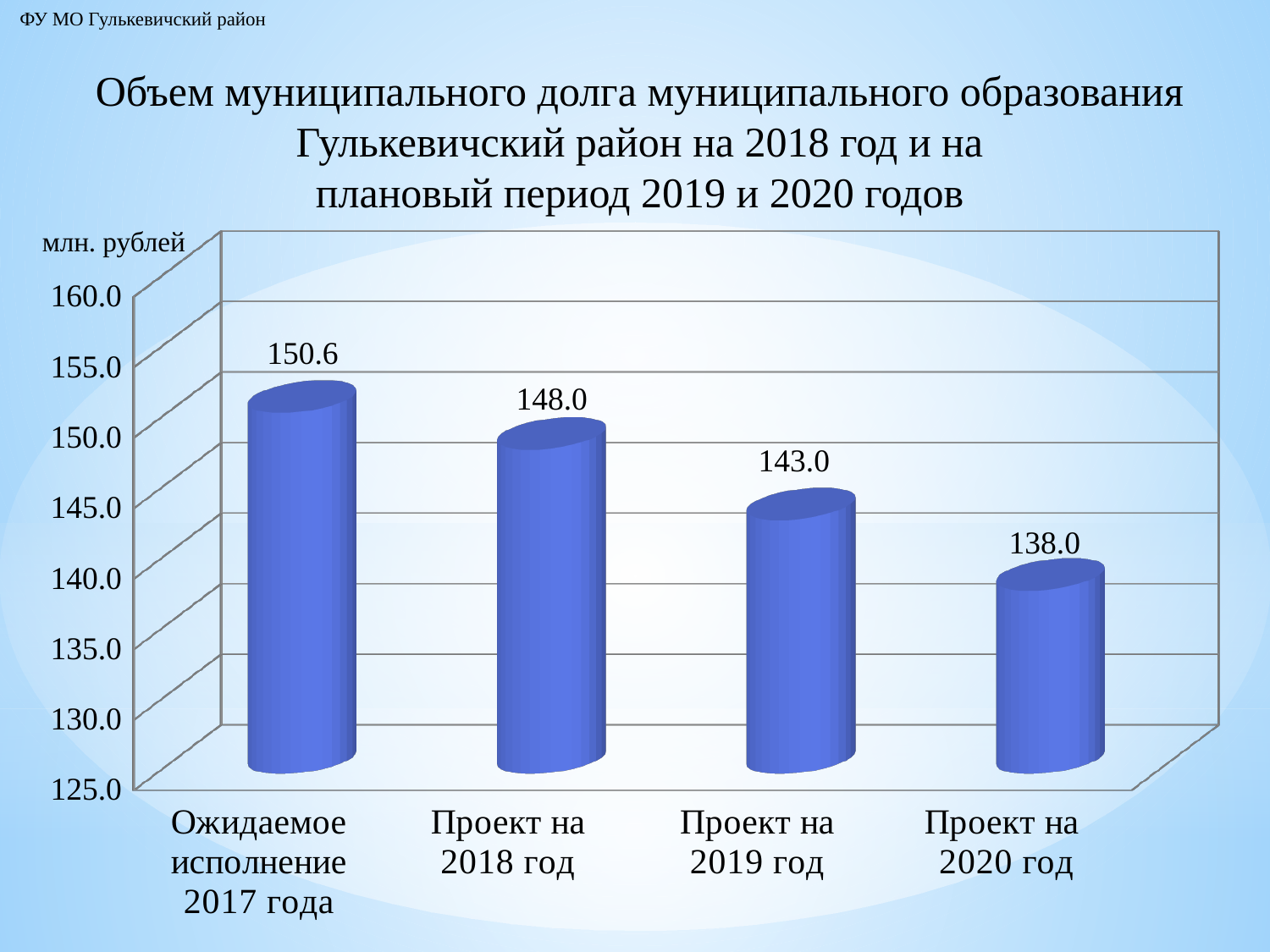
What is the value for "Проект на 2018 год"? 148.0 How many categories are shown on the chart? 4 What is the difference between the values for "Проект на 2018 год" and "Проект на 2019 год"? 5.0 Which is larger, the value for "Проект на 2019 год" or "Проект на 2020 год"? Проект на 2019 год Which category has the lowest value? Проект на 2020 год What is the value for "Проект на 2020 год"? 138.0 Do the values rise or fall from left to right along the x axis? fall What kind of chart is shown on the slide? bar chart Is the value for "Проект на 2019 год" greater or less than 145.0? less What is the value for "Ожидаемое исполнение 2017 года"? 150.6 Which category has the highest value? Ожидаемое исполнение 2017 года What is the difference between the values for "Ожидаемое исполнение 2017 года" and "Проект на 2020 год"? 12.6